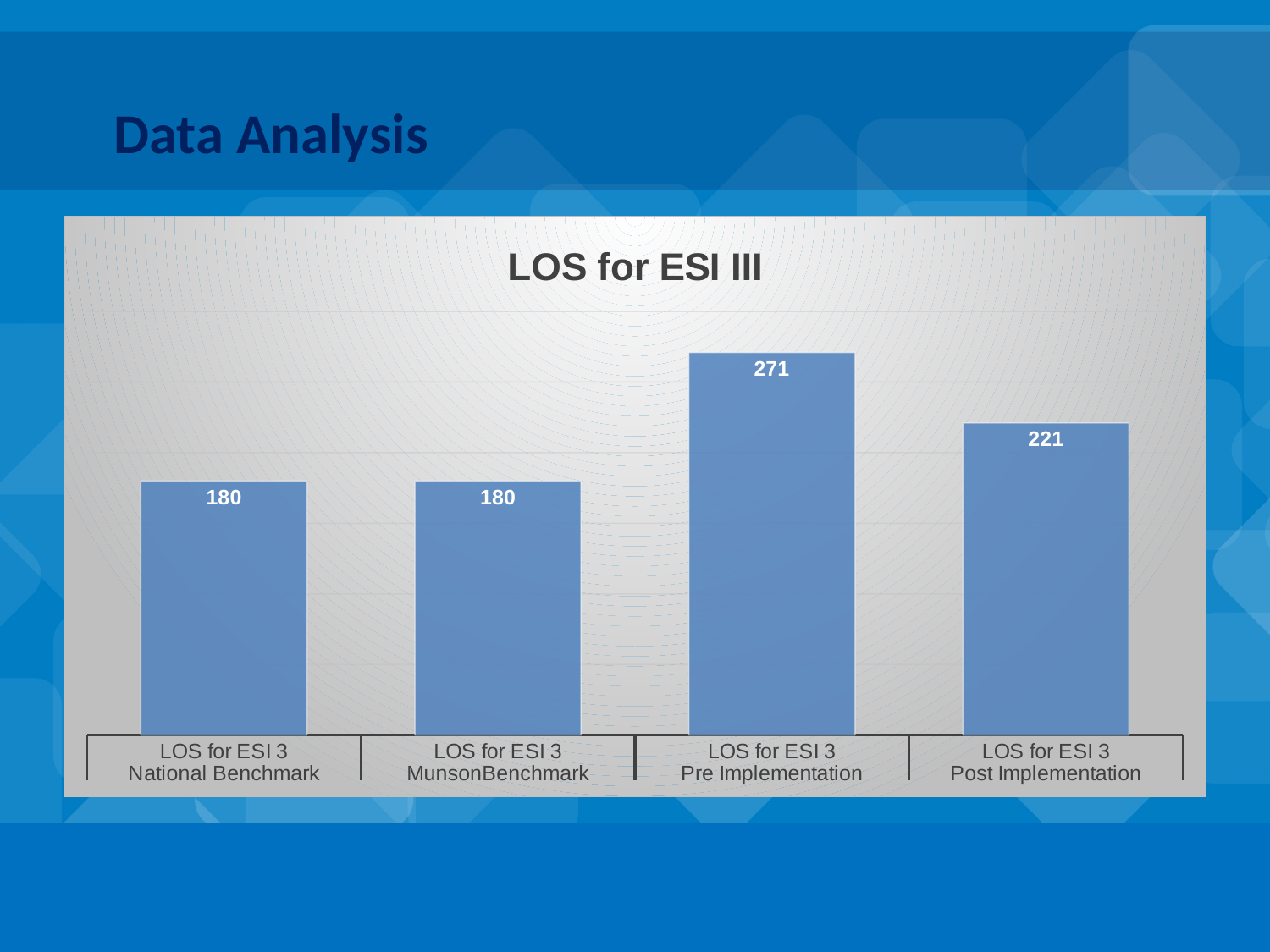
What is the value for LOS for ESI 3 MunsonBenchmark? 180 What is the difference between the Pre Implementation and Post Implementation values? 50 Which category has the highest value? LOS for ESI 3 Pre Implementation What is the value for LOS for ESI 3 Pre Implementation? 271 What is the value for LOS for ESI 3 Post Implementation? 221 What is the title of the chart? LOS for ESI III What is the difference between the Post Implementation value and the National Benchmark value? 41 Which is larger, the value for Pre Implementation or the value for Post Implementation? Pre Implementation What kind of chart is shown on the slide? Bar chart Which is larger, the value for Post Implementation or the value for MunsonBenchmark? Post Implementation How many bars are shown in the chart? 4 What is the value for LOS for ESI 3 National Benchmark? 180